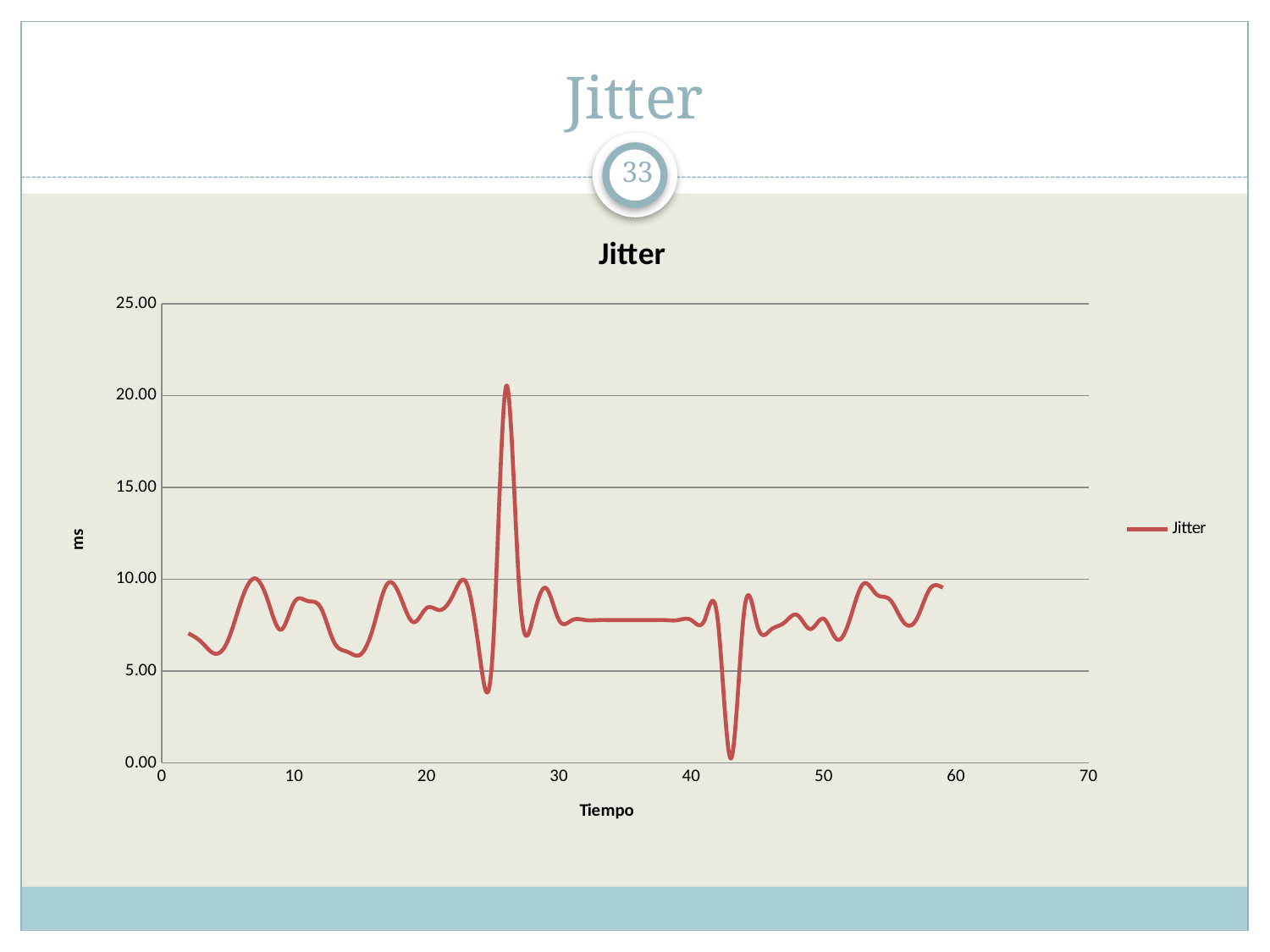
Which is larger, the value of the Jitter line at Tiempo 26 or at Tiempo 43? Tiempo 26 Is the peak value of the Jitter line near Tiempo 26 greater or less than 15.00? greater Is the value of the Jitter line at Tiempo 35 greater or less than 10.00? less How many series does the legend list? 1 What is the label of the x axis? Tiempo What is the maximum value shown on the y axis? 25.00 Is the value of the Jitter line at Tiempo 35 greater or less than 5.00? greater What kind of chart is shown on the slide? line chart What is the title of the chart? Jitter